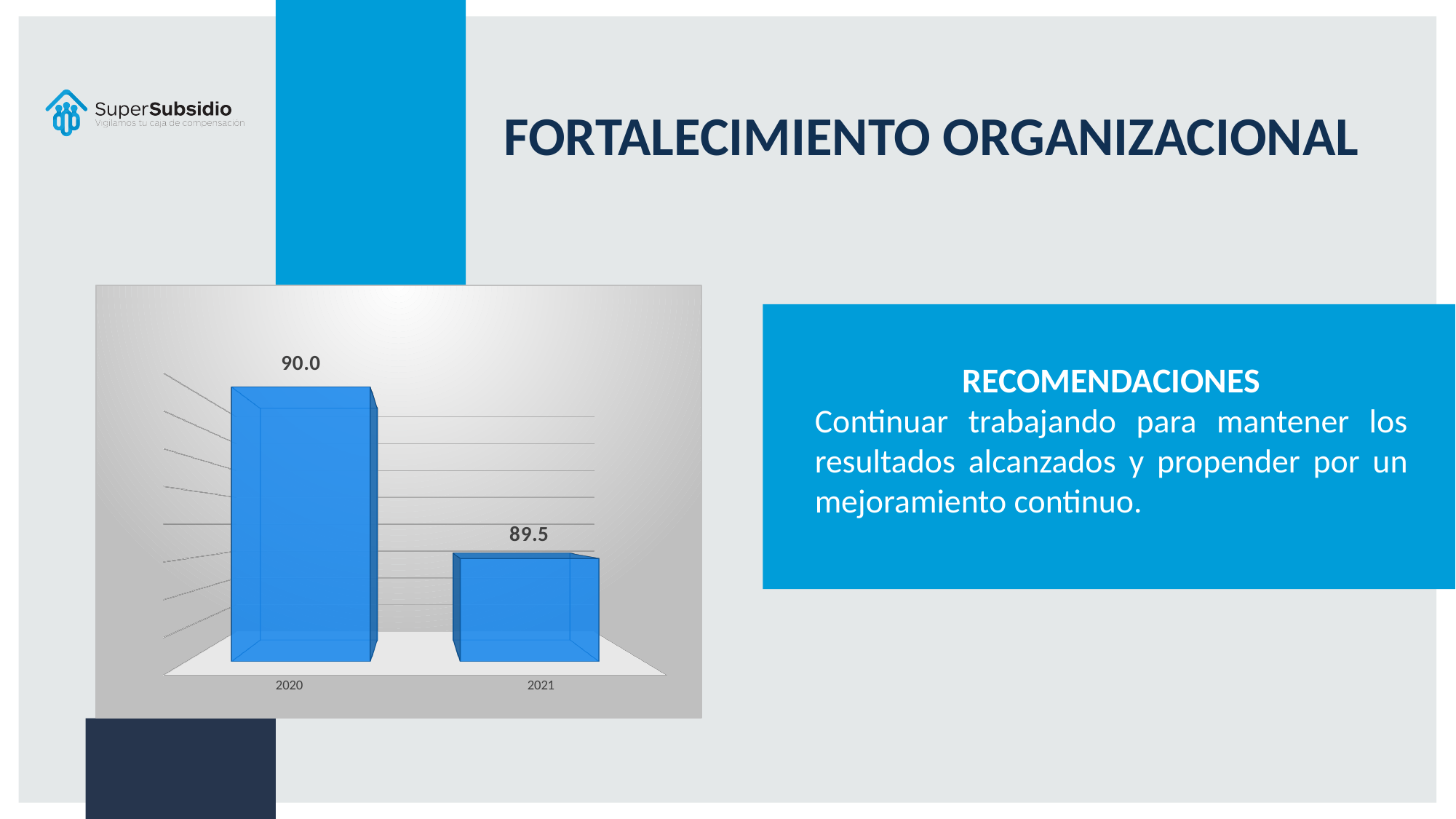
Which year has the highest value? 2020 What colour are the bars in the chart? blue Which is larger, the value for 2020 or the value for 2021? 2020 What kind of chart is shown on the slide? bar chart What is the value for 2020? 90.0 What is the value for 2021? 89.5 What is the difference between the values for 2020 and 2021? 0.5 What is the title of the slide containing the chart? FORTALECIMIENTO ORGANIZACIONAL Which year has the lowest value? 2021 How many categories are shown on the x axis? 2 Do the values rise or fall from 2020 to 2021? fall